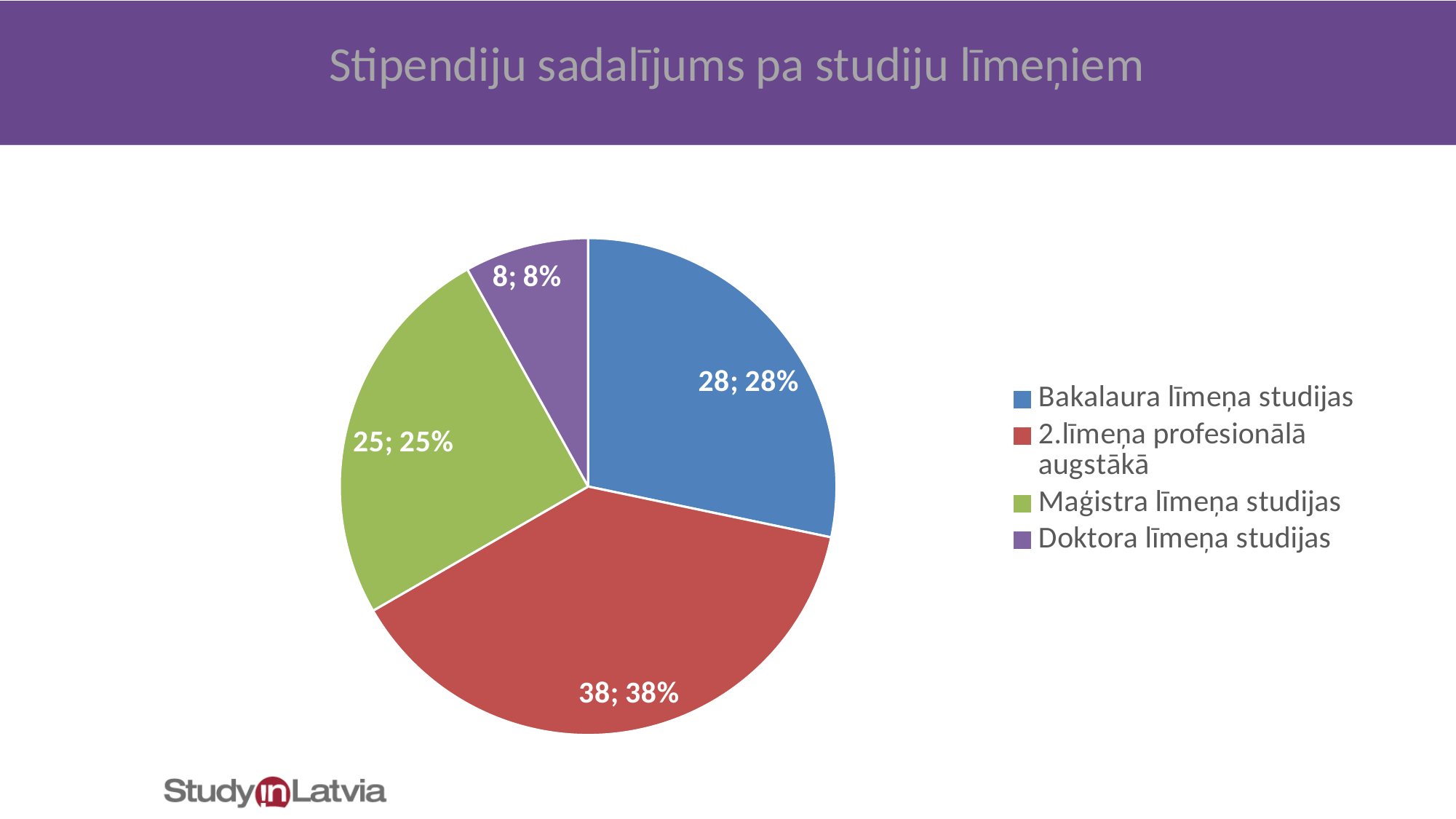
Which category has the smallest slice? Doktora līmeņa studijas How many categories does the pie chart have? 4 What is the title of the slide? Stipendiju sadalījums pa studiju līmeņiem Which is larger, the value for Bakalaura līmeņa studijas or Maģistra līmeņa studijas? Bakalaura līmeņa studijas What is the value for Bakalaura līmeņa studijas? 28 What is the value for Maģistra līmeņa studijas? 25 What share of the pie does Maģistra līmeņa studijas represent? 25% Which category has the largest slice? 2.līmeņa profesionālā augstākā What type of chart is shown on the slide? pie chart What is the value for 2.līmeņa profesionālā augstākā? 38 What is the difference between the values for 2.līmeņa profesionālā augstākā and Bakalaura līmeņa studijas? 10 What is the value for Doktora līmeņa studijas? 8